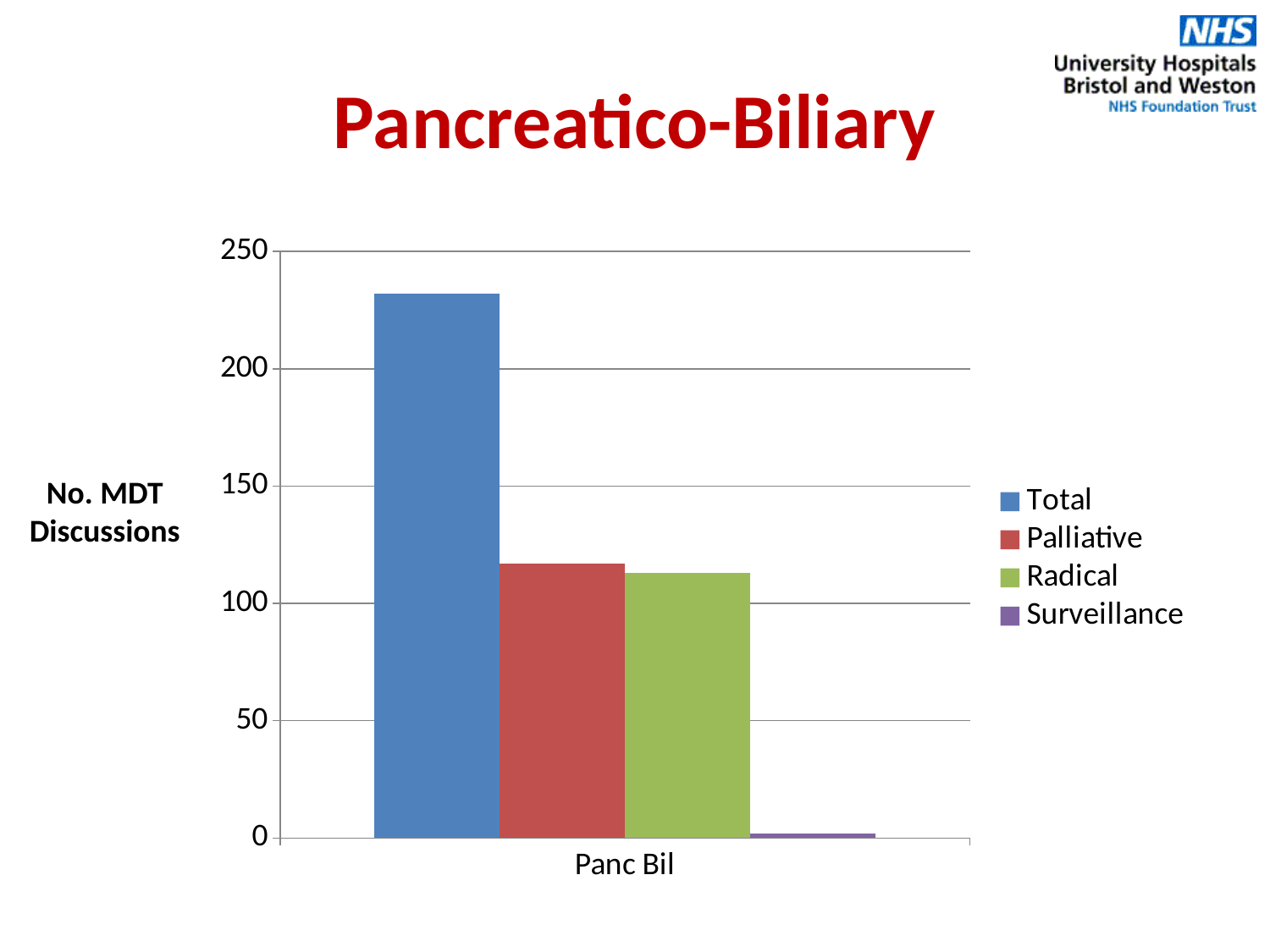
Which series has the highest value for Panc Bil? Total Which is larger, the value for Total or the value for Palliative? Total Which series has the lowest value for Panc Bil? Surveillance What kind of chart is shown on the slide? bar chart Is the value for Surveillance greater or less than 50? less Is the value for Total greater or less than 200? greater Is the value for Palliative greater or less than 100? greater What is the label on the vertical axis? No. MDT Discussions How many series does the legend list? 4 What is the label on the x axis category? Panc Bil